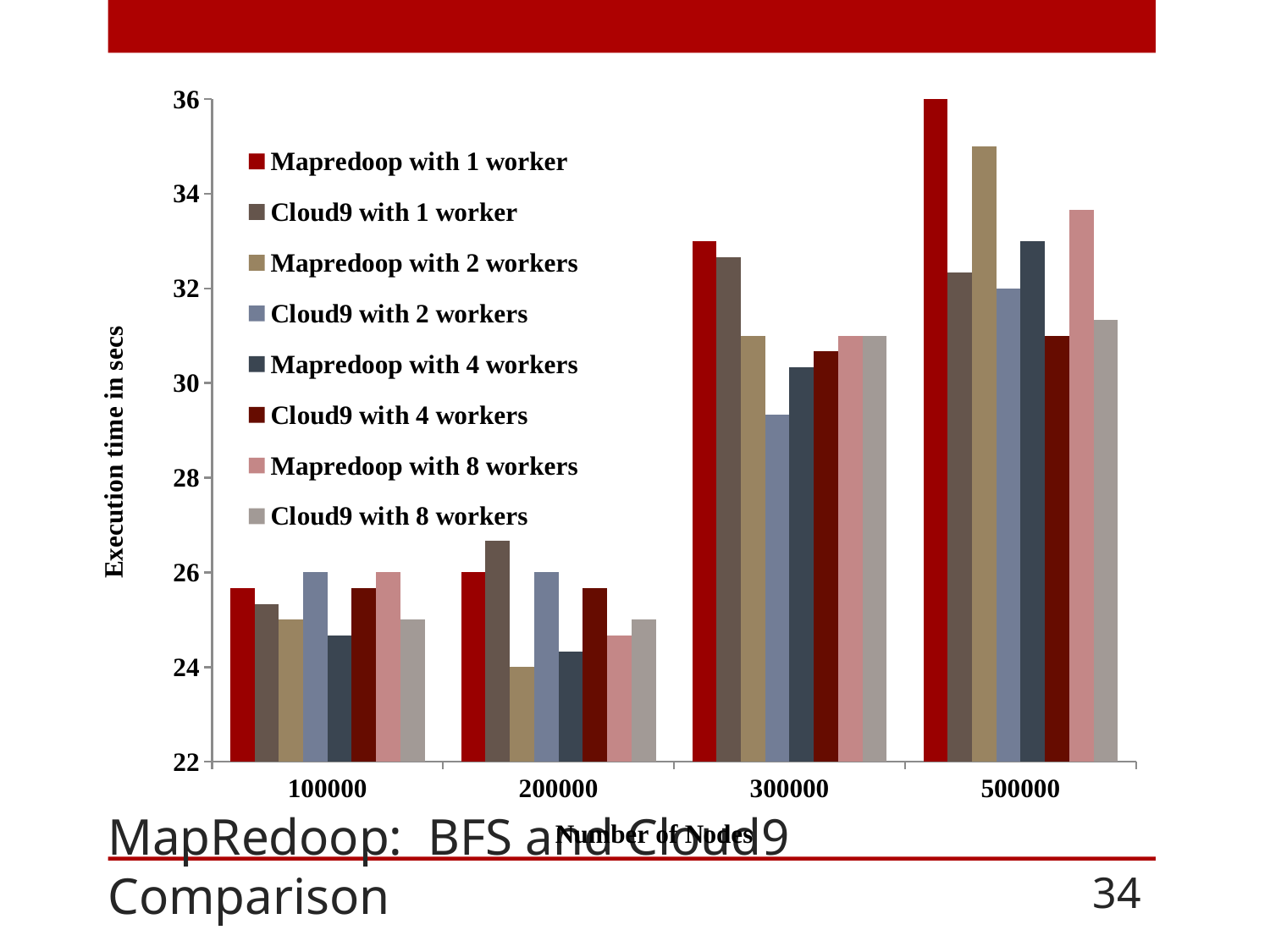
Which series has the shortest bar in the 200000 nodes group? Mapredoop with 2 workers Which series has the tallest bar in the 500000 nodes group? Mapredoop with 1 worker Is the value for Mapredoop with 4 workers at 100000 nodes greater or less than 26? less What kind of chart is shown on the slide? bar chart Is the value for Cloud9 with 8 workers at 200000 nodes greater or less than 26? less How many series does the legend list? 8 Is the value for Mapredoop with 2 workers at 500000 nodes greater or less than 34? greater What is the label of the y axis? Execution time in secs Does the execution time for Mapredoop with 1 worker rise or fall as the number of nodes increases? rise At 300000 nodes, which is larger: Mapredoop with 1 worker or Cloud9 with 2 workers? Mapredoop with 1 worker How many node-count categories are shown on the x axis? 4